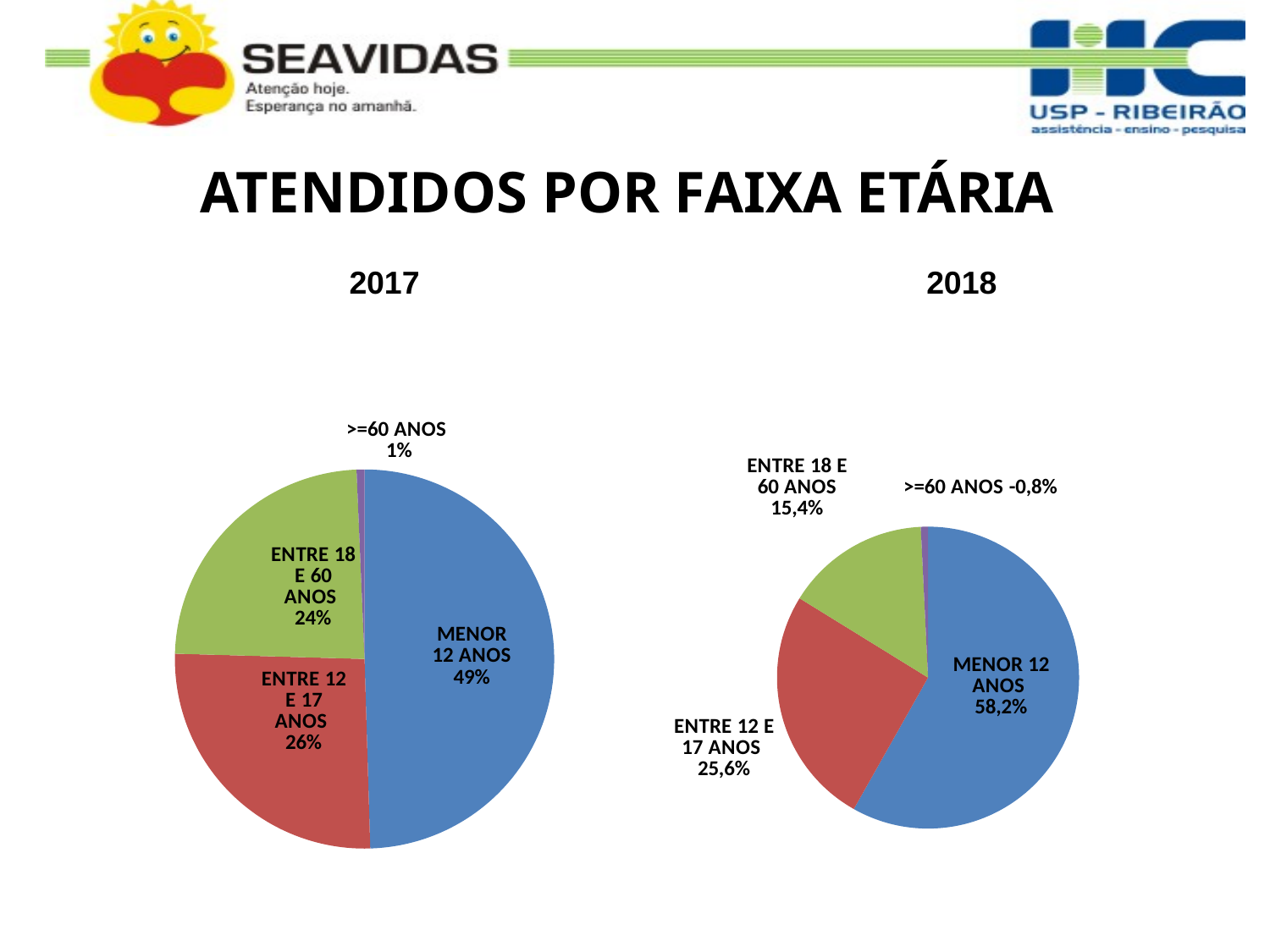
In the 2018 pie chart, which is larger: ENTRE 12 E 17 ANOS or ENTRE 18 E 60 ANOS? ENTRE 12 E 17 ANOS In the 2018 pie chart, what share is shown for >=60 ANOS? 0,8% In the 2017 pie chart, what share is shown for MENOR 12 ANOS? 49% How many slices does the 2017 pie chart have? 4 In the 2018 pie chart, what share is shown for ENTRE 12 E 17 ANOS? 25,6% In the 2018 pie chart, what share is shown for MENOR 12 ANOS? 58,2% In the 2017 pie chart, which age group has the largest share? MENOR 12 ANOS What type of chart is used for the 2018 data? Pie chart In the 2018 pie chart, which age group has the smallest share? >=60 ANOS In the 2017 pie chart, what is the difference in percentage points between ENTRE 12 E 17 ANOS and ENTRE 18 E 60 ANOS? 2 What is the title of the slide containing the two charts? ATENDIDOS POR FAIXA ETÁRIA In the 2017 pie chart, what share is shown for ENTRE 18 E 60 ANOS? 24%